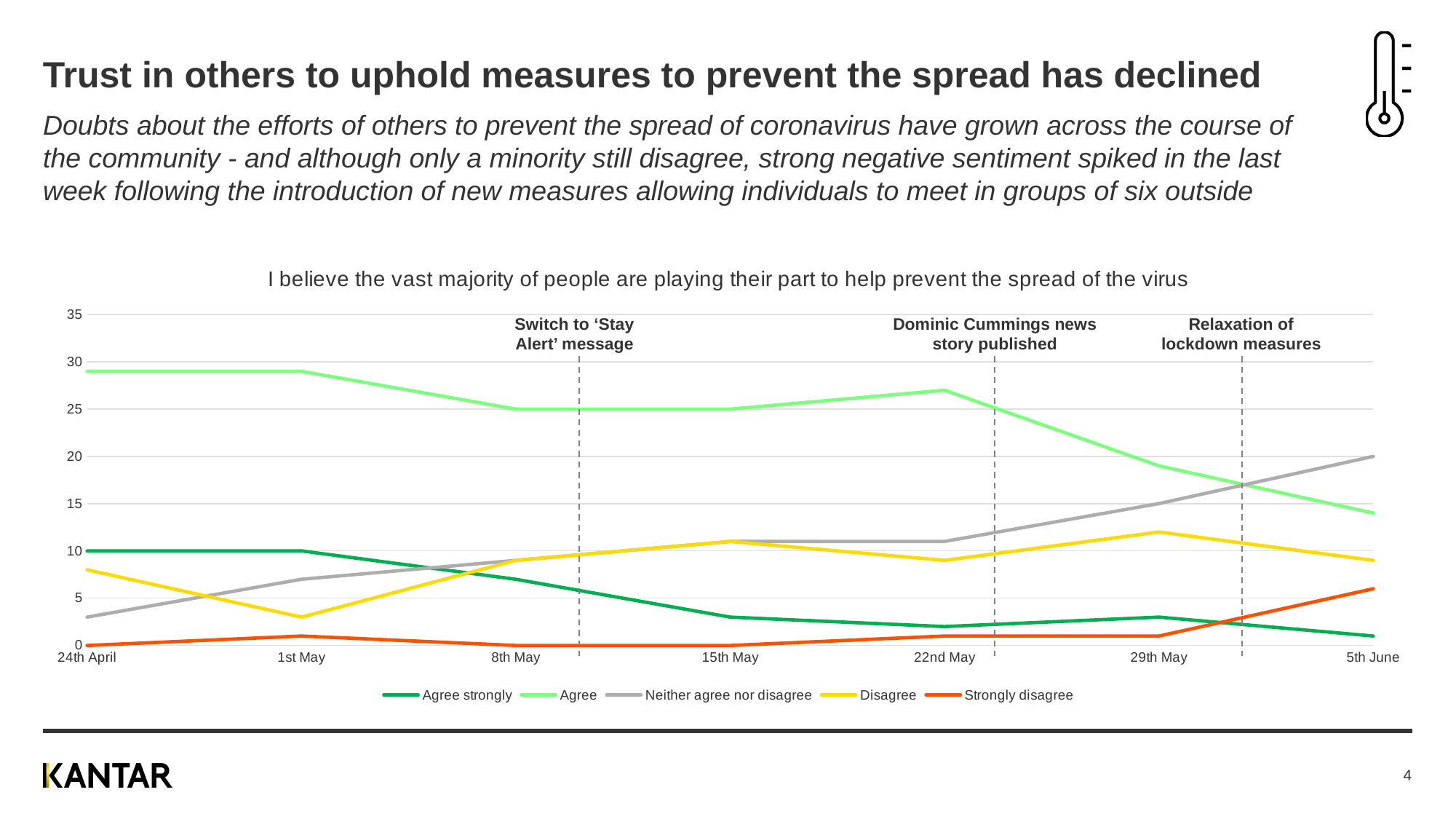
How many series does the legend list? 5 What kind of chart is shown on the slide? line chart What is the value for Agree on 8th May? 25 Which series has the lowest value on 5th June? Agree strongly Which series has the highest value on 24th April? Agree Does the Agree strongly line rise or fall from 24th April to 5th June? fall What is the value for Neither agree nor disagree on 5th June? 20 How many dates are shown along the x axis? 7 Is the value for Agree on 24th April greater or less than 25? greater What is the value for Agree strongly on 24th April? 10 Is the value for Strongly disagree on 5th June greater or less than 10? less Which is larger on 5th June, Neither agree nor disagree or Agree? Neither agree nor disagree